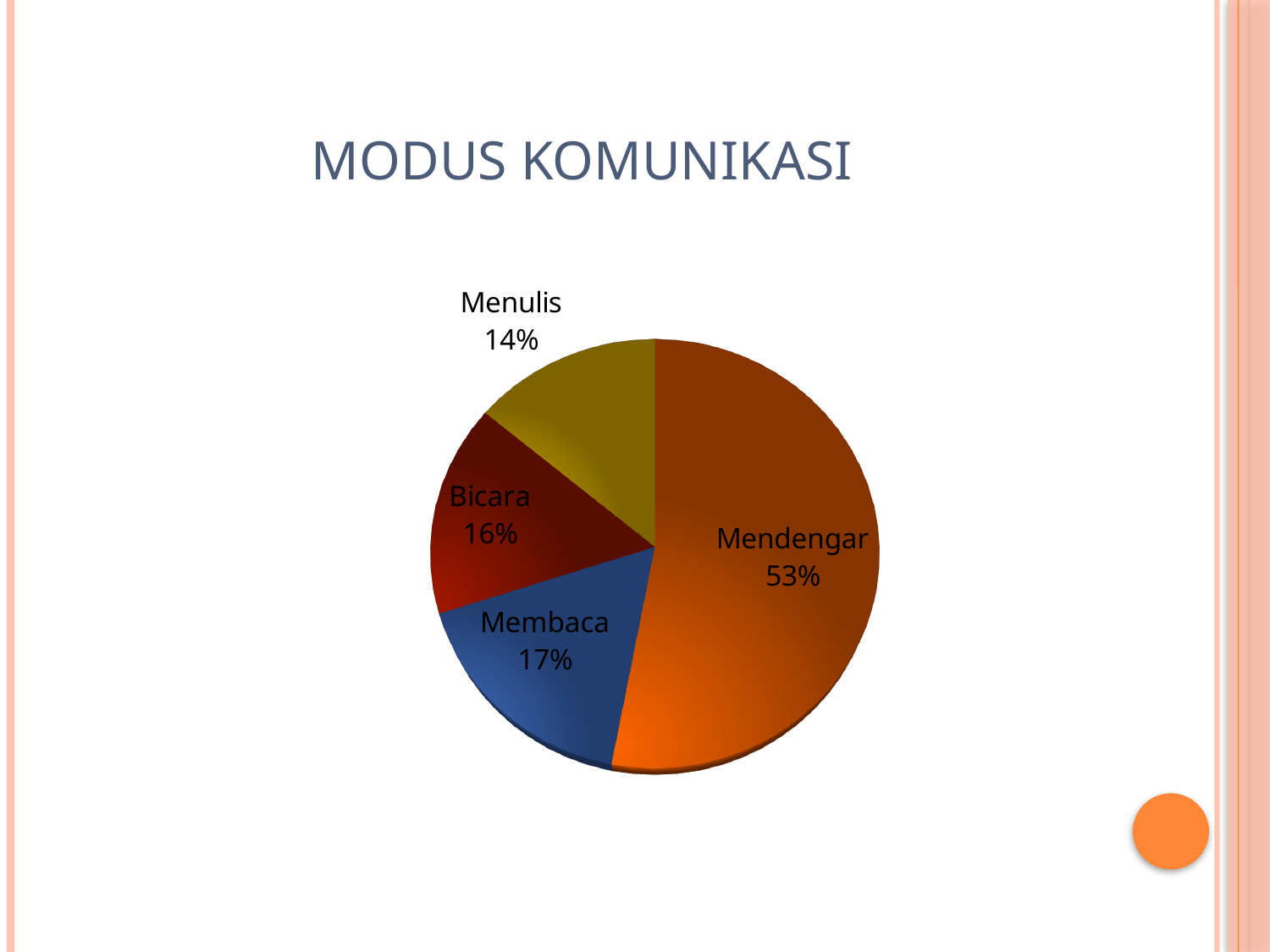
Which is larger, the share for Mendengar or the share for Bicara? Mendengar What percentage does the Bicara slice represent? 16% What percentage does the Menulis slice represent? 14% What percentage does the Membaca slice represent? 17% What is the difference in percentage points between Mendengar and Membaca? 36 What percentage does the Mendengar slice represent? 53% Which category has the largest share of the pie? Mendengar What is the difference in percentage points between Bicara and Menulis? 2 What kind of chart is shown on the slide? Pie chart How many slices does the pie chart have? 4 Which category has the smallest share of the pie? Menulis What is the title of the slide containing the chart? MODUS KOMUNIKASI